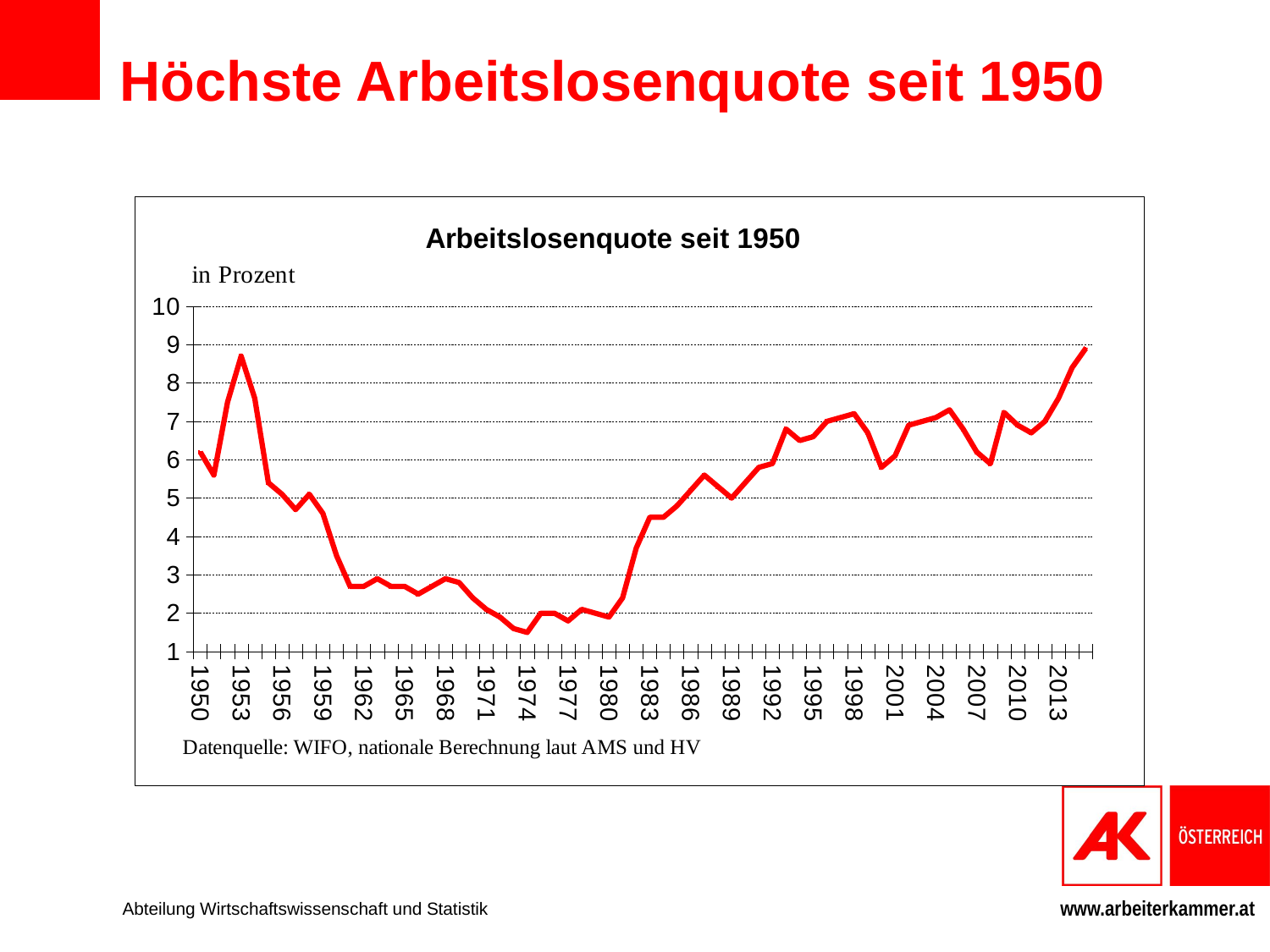
Is the value for 1962 greater or less than 3? less Is the value for 1974 greater or less than 2? less Which is larger, the value for 1953 or the value for 1974? 1953 What kind of chart is shown on the slide? line chart Is the value for 2013 greater or less than 7? greater Which year has the lowest unemployment rate on the chart? 1974 Does the unemployment rate rise or fall between 1953 and 1974? fall In what unit are the values on the chart given, according to the label above the y axis? in Prozent What is the title of the chart? Arbeitslosenquote seit 1950